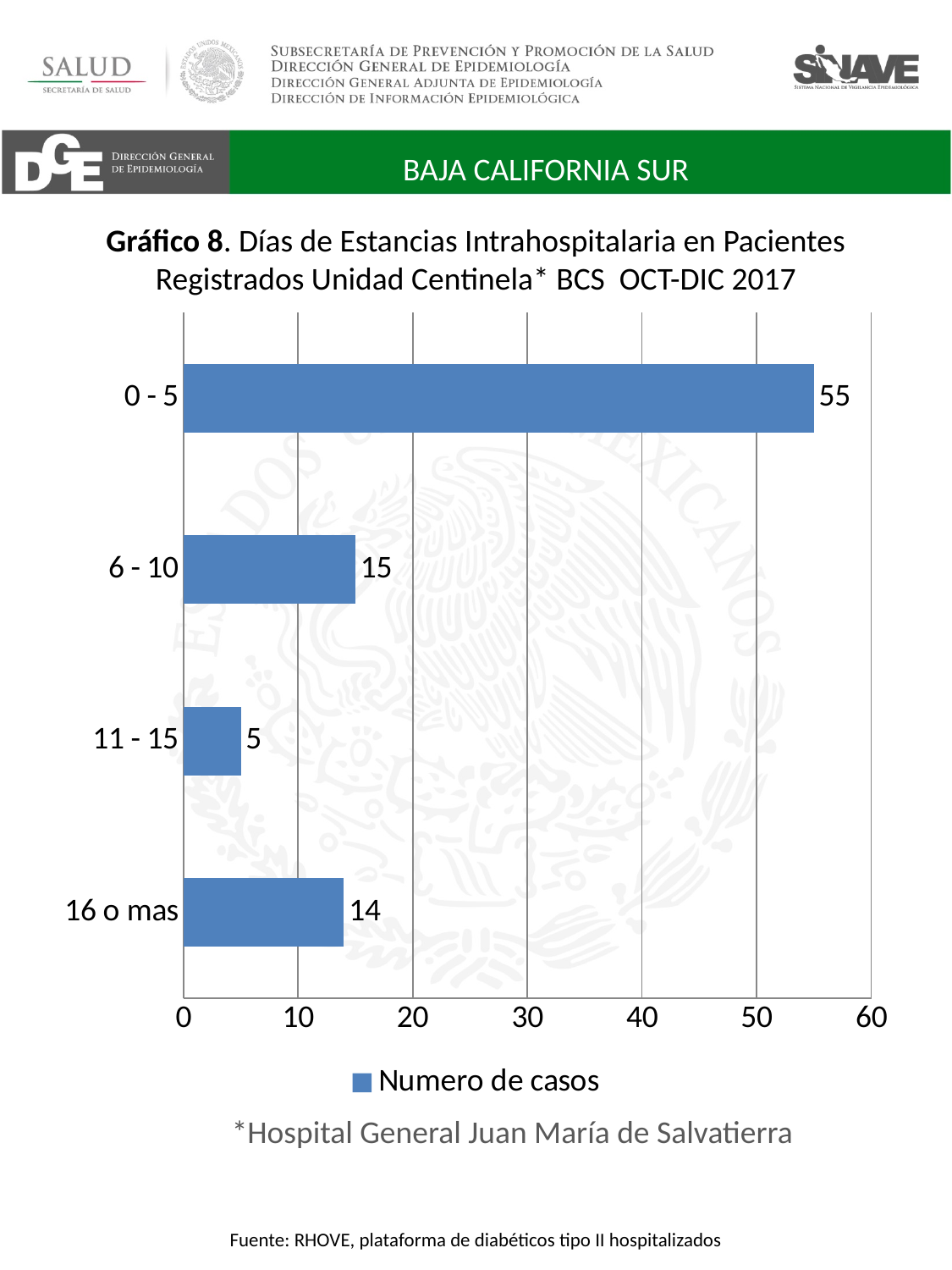
What kind of chart is shown on the slide? Bar chart How many categories are shown on the chart? 4 What is the number of cases for the 16 o mas category? 14 Which category has the lowest number of cases? 11 - 15 Which has more cases, 6 - 10 or 16 o mas? 6 - 10 What is the number of cases for the 6 - 10 days category? 15 Which category has the highest number of cases? 0 - 5 What is the difference in number of cases between the 0 - 5 and 6 - 10 categories? 40 What is the number of cases for the 0 - 5 days category? 55 Is the value for 0 - 5 greater or less than 50? greater What is the number of cases for the 11 - 15 days category? 5 What series name does the legend show? Numero de casos